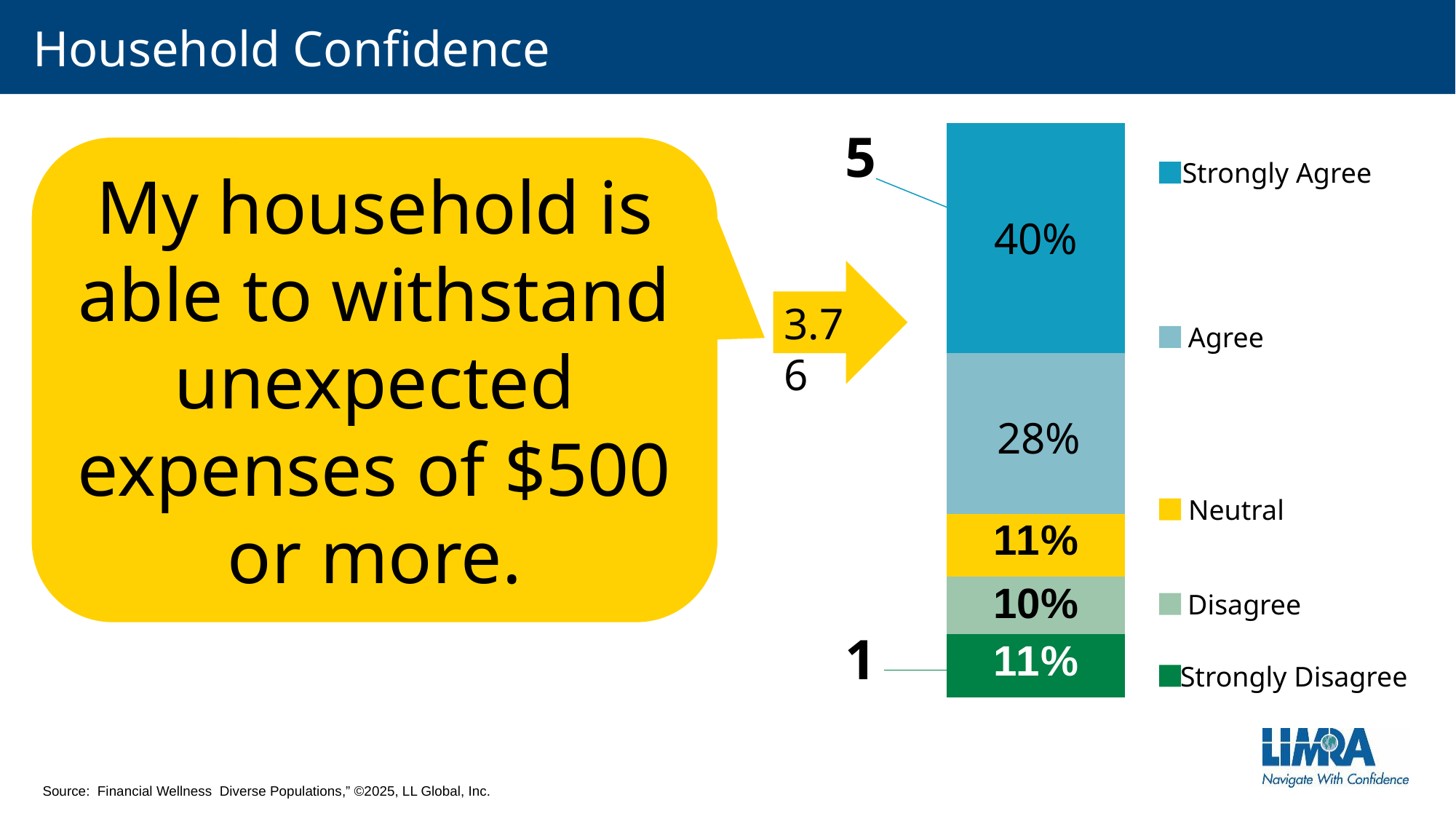
What is the difference in percentage points between Strongly Agree and Agree? 12 Which response category has the largest share? Strongly Agree Which response category has the smallest share? Disagree Which is larger, the share for Agree or the share for Neutral? Agree What percentage of respondents chose Disagree? 10% What kind of chart is shown on the slide? Stacked bar chart What percentage of respondents chose Neutral? 11% What percentage of respondents chose Strongly Disagree? 11% How many response categories does the legend list? 5 What is the combined percentage of respondents who Strongly Agree or Agree? 68% What percentage of respondents Strongly Agree that their household can withstand unexpected expenses of $500 or more? 40% What percentage of respondents chose Agree? 28%